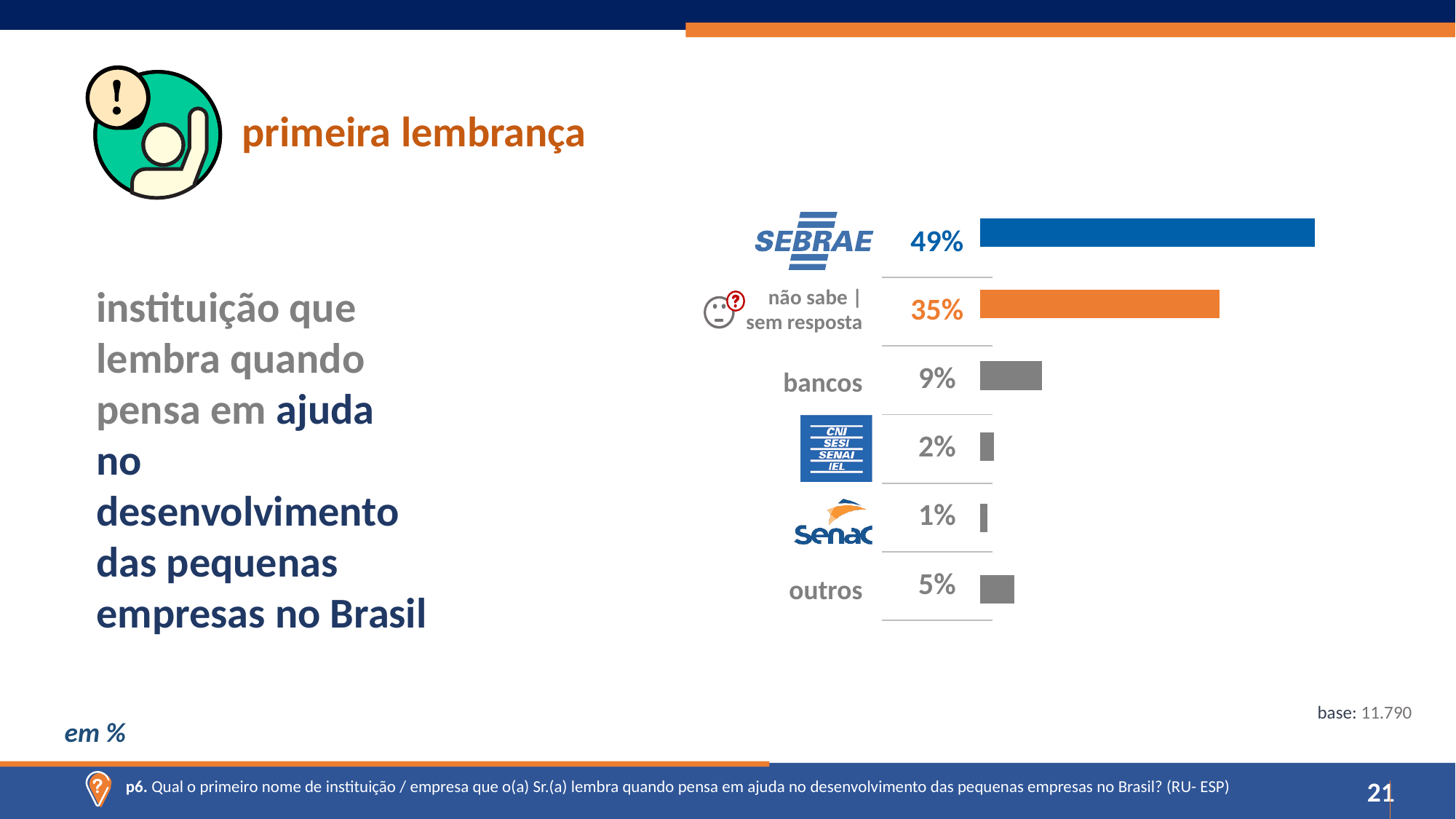
How many categories are shown in the chart? 6 Which category has the lowest value in the chart? Senac What percentage is shown for "bancos"? 9% What is the value shown for "outros"? 5% Which category has the highest value in the chart? SEBRAE What percentage of respondents named SEBRAE as the first institution they remember? 49% What is the difference between the value for SEBRAE and the value for "não sabe | sem resposta"? 14% What is the base (number of respondents) shown on the slide? 11.790 What is the value shown for "não sabe | sem resposta"? 35% What kind of chart is shown on the slide? bar chart Which is larger, the value for "bancos" or the value for "outros"? bancos What percentage is shown for Senac? 1%